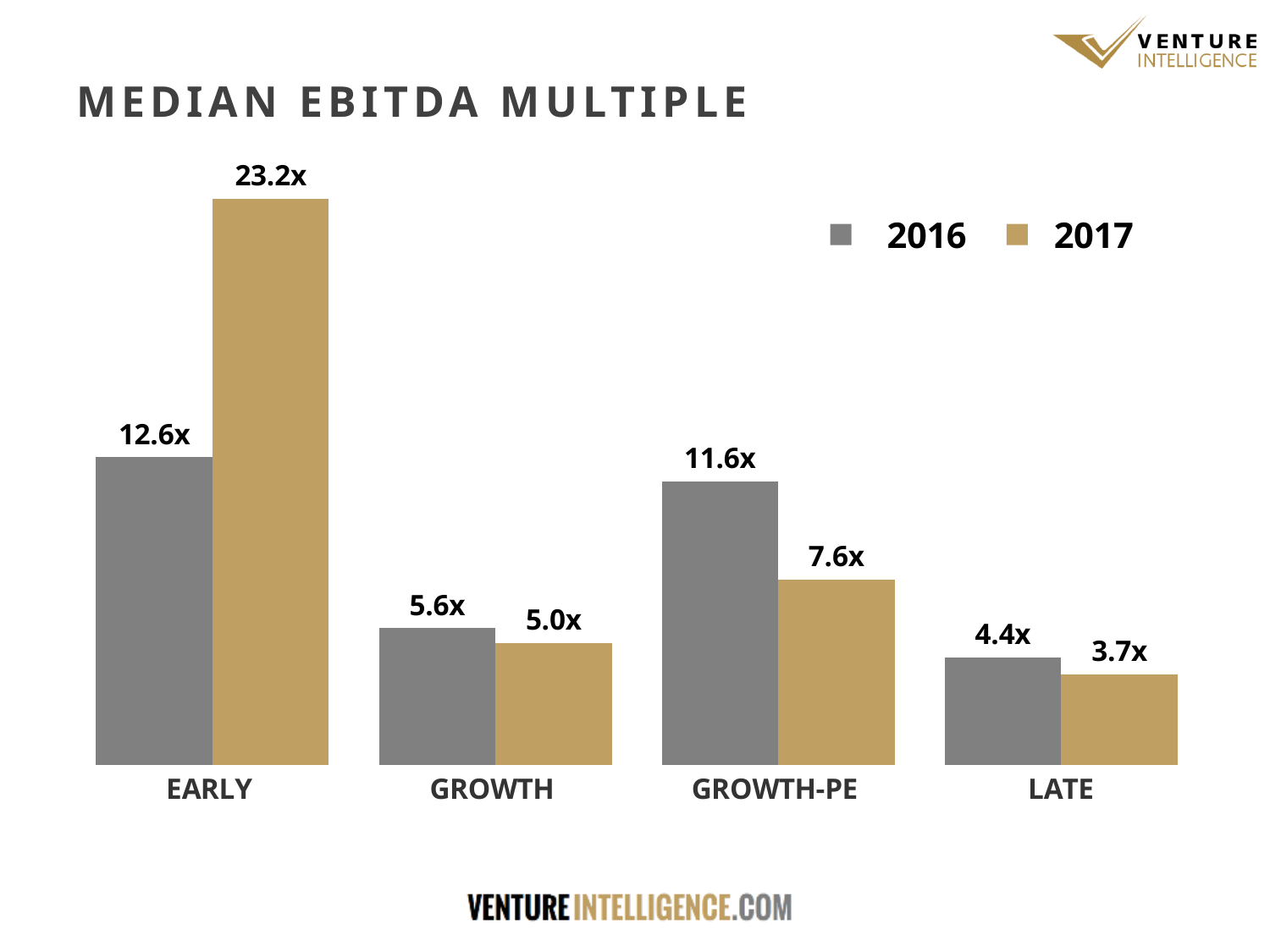
What is the median EBITDA multiple for LATE in 2017? 3.7x What is the difference between the 2016 and 2017 median EBITDA multiples for GROWTH-PE? 4.0x Which is larger, the 2016 or the 2017 median EBITDA multiple for GROWTH? 2016 How many categories are shown on the x axis? 4 How many series does the legend list? 2 Which colour represents 2017 in the chart? Gold What is the median EBITDA multiple for EARLY in 2017? 23.2x Which category has the highest 2017 median EBITDA multiple? EARLY What is the difference between the 2017 and 2016 median EBITDA multiples for EARLY? 10.6x What is the median EBITDA multiple for GROWTH-PE in 2016? 11.6x What kind of chart is shown on the slide? Bar chart Which category has the lowest 2016 median EBITDA multiple? LATE